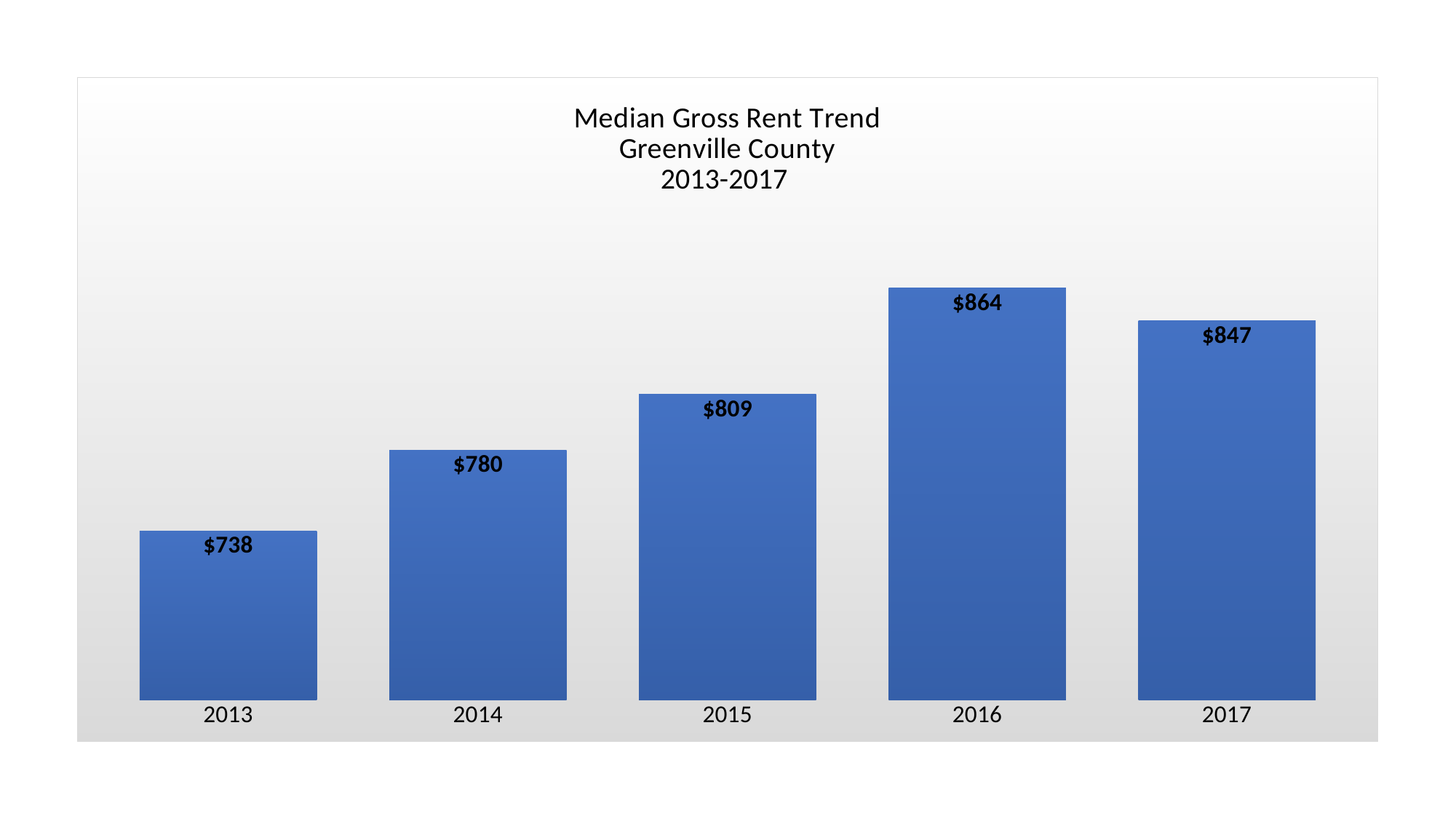
Which year has the lowest median gross rent? 2013 What is the median gross rent for 2013? $738 Which year has a higher median gross rent, 2016 or 2017? 2016 What is the title of the chart? Median Gross Rent Trend Greenville County 2013-2017 What kind of chart is shown on the slide? Bar chart Does the median gross rent rise or fall from 2013 to 2016? Rise What is the difference between the median gross rent in 2014 and 2015? $29 What is the median gross rent for 2017? $847 What is the median gross rent for 2015? $809 What is the difference between the median gross rent in 2016 and 2013? $126 How many years are shown on the chart? 5 Which year has the highest median gross rent? 2016